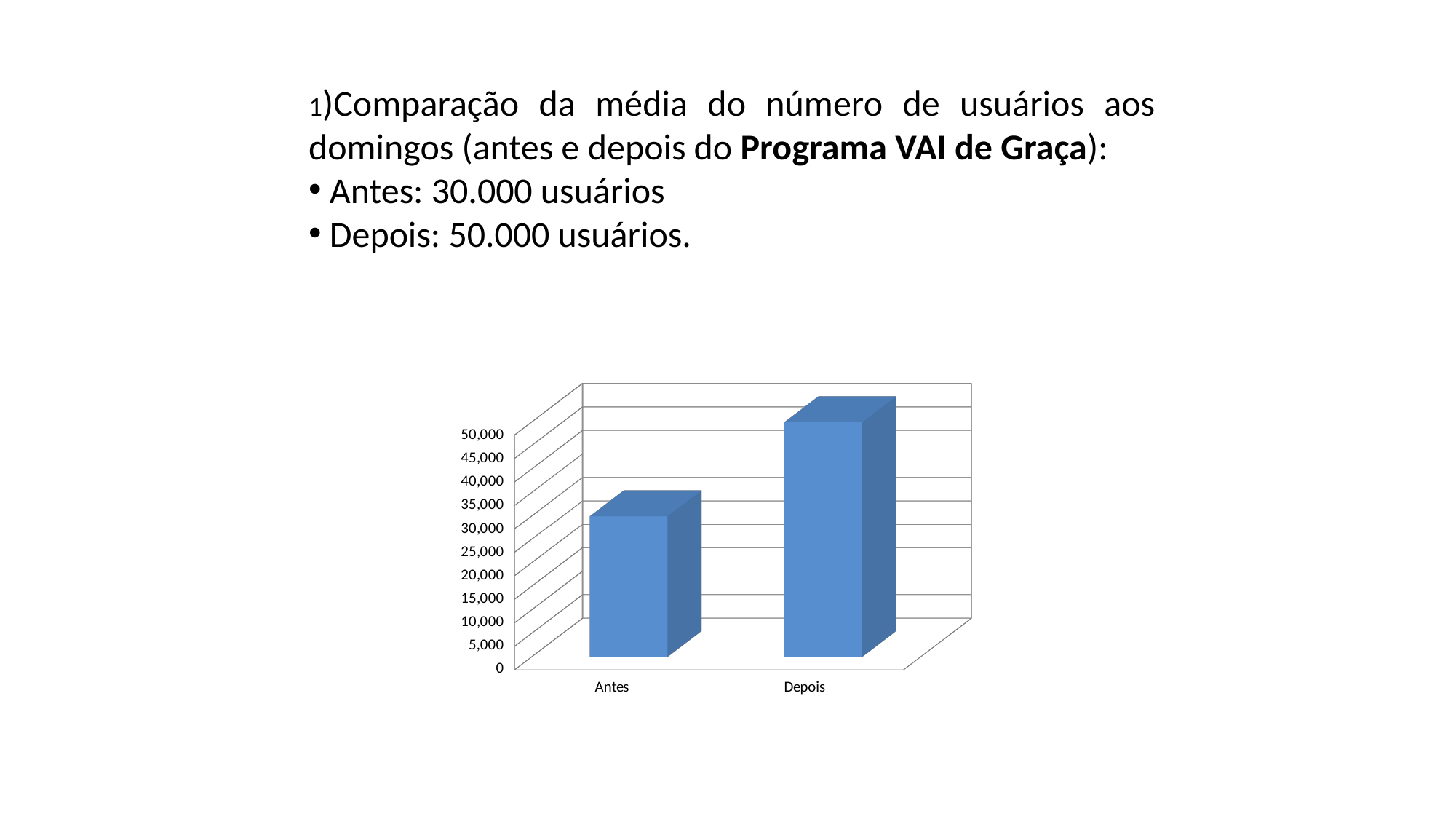
Which category has the lowest value? Antes What is the difference between the Depois and Antes values? 20,000 Is the value for Antes greater or less than 40,000? less What is the value of the Antes bar? 30,000 What is the highest tick label shown on the vertical axis? 50,000 Which category has the highest value? Depois Which is larger, the value for Antes or the value for Depois? Depois How many categories are shown on the x axis? 2 What is the value of the Depois bar? 50,000 What kind of chart is shown on the slide? bar chart Do the values rise or fall from Antes to Depois? rise Is the value for Depois greater or less than 45,000? greater